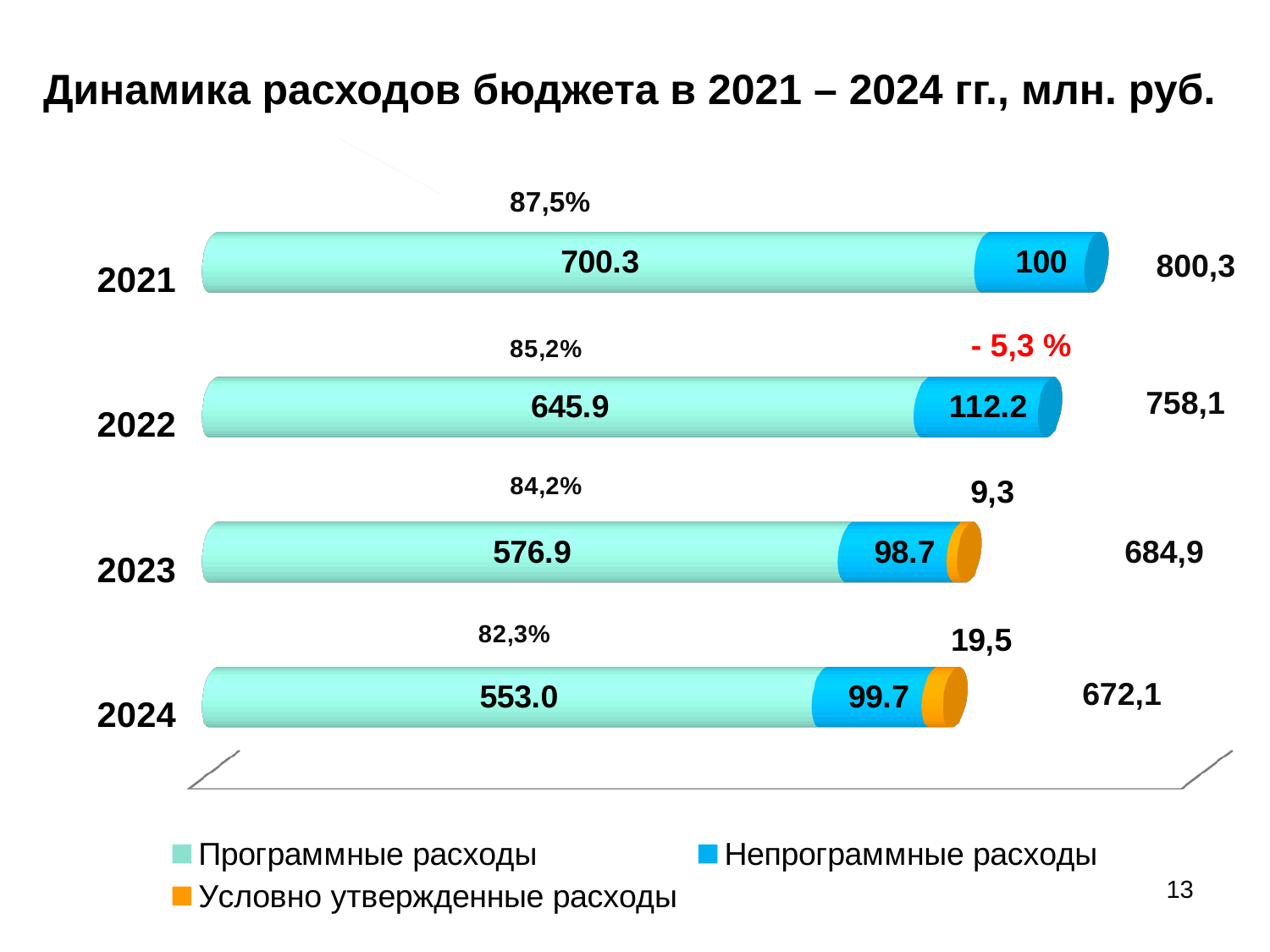
How many series does the legend list? 3 Which year has the lowest value of Программные расходы? 2024 What is the total of the stacked bar for 2022? 758,1 What is the value of Программные расходы for 2021? 700.3 What is the value of Непрограммные расходы for 2022? 112.2 What is the value of Программные расходы for 2023? 576.9 What is the difference between Программные расходы in 2021 and 2022? 54.4 What type of chart is shown on the slide? bar chart Which year has the highest value of Программные расходы? 2021 What is the value of Условно утвержденные расходы for 2024? 19,5 How many years are shown on the chart? 4 Which is larger: Непрограммные расходы in 2023 or in 2024? 2024